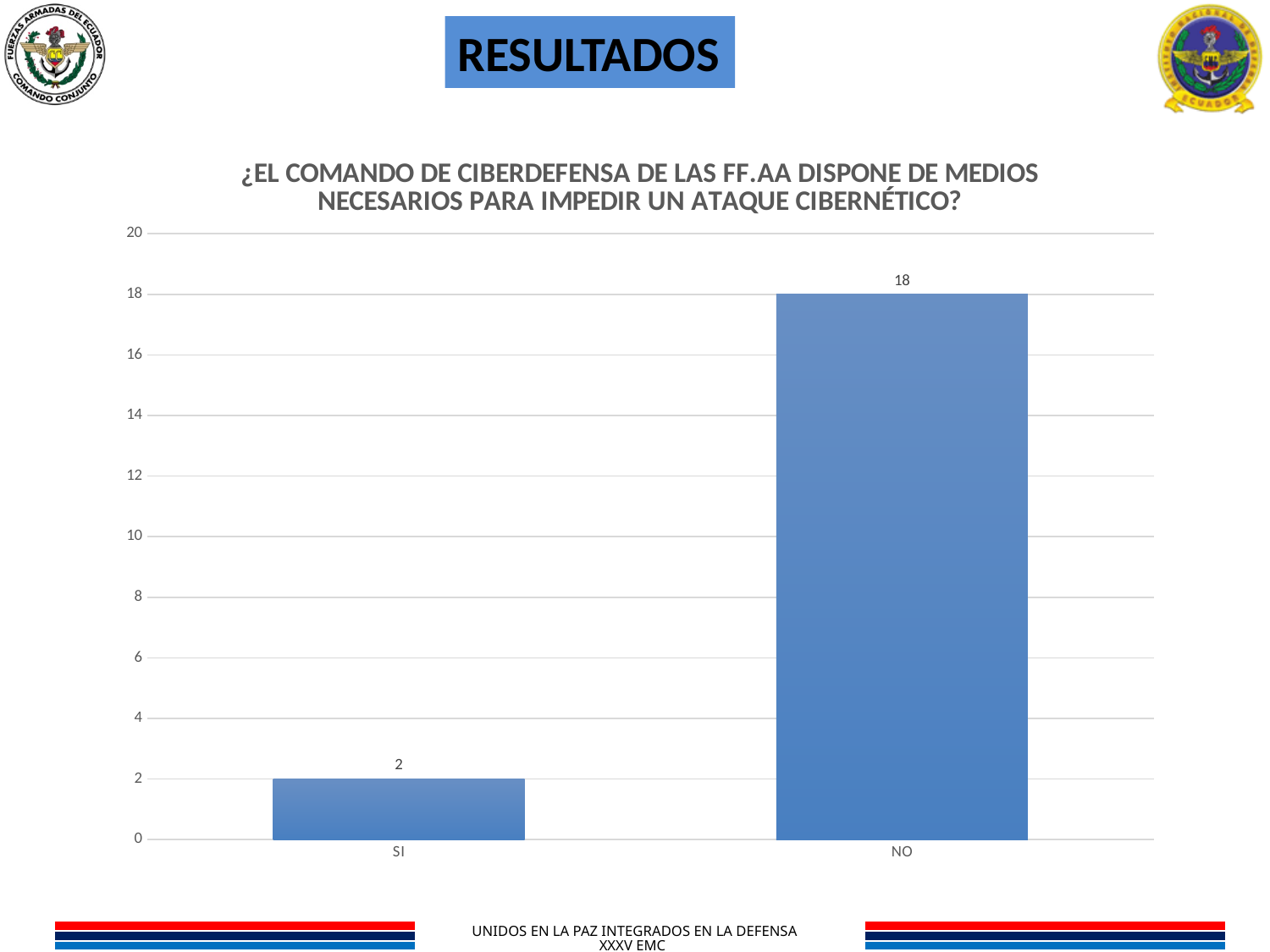
Which is larger, the value for SI or the value for NO? NO What is the value for NO? 18 How many categories are shown on the x axis? 2 Which category has the lowest value? SI What is the total of the two values shown in the chart? 20 What is the value for SI? 2 What kind of chart is shown on the slide? bar chart What is the maximum value shown on the vertical axis? 20 Which category has the highest value? NO Is the value for SI greater or less than 4? less Is the value for NO greater or less than 10? greater What is the difference between the values for NO and SI? 16